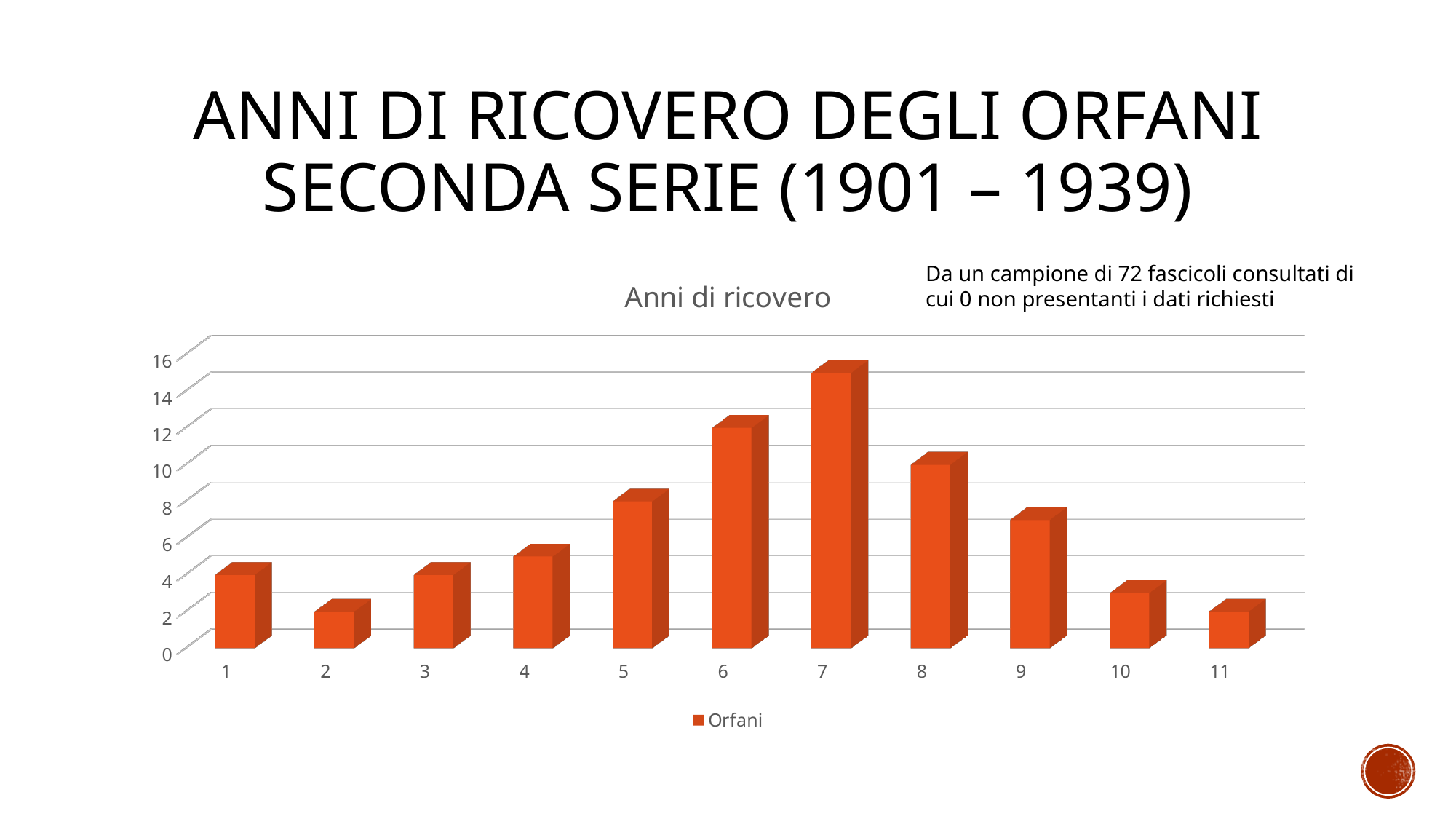
Which has the larger value, category 1 or category 2? 1 What kind of chart is shown on the slide? bar chart Which has the larger value, category 6 or category 8? 6 How many categories are shown on the x axis of the chart? 11 Which category has the highest bar in the chart? 7 Is the value for category 6 greater or less than 10? greater Do the values rise or fall from category 7 to category 11? fall Is the value for category 2 greater or less than 4? less Is the value for category 7 greater or less than 14? greater What is the name of the series shown in the chart legend? Orfani How many series does the chart legend list? 1